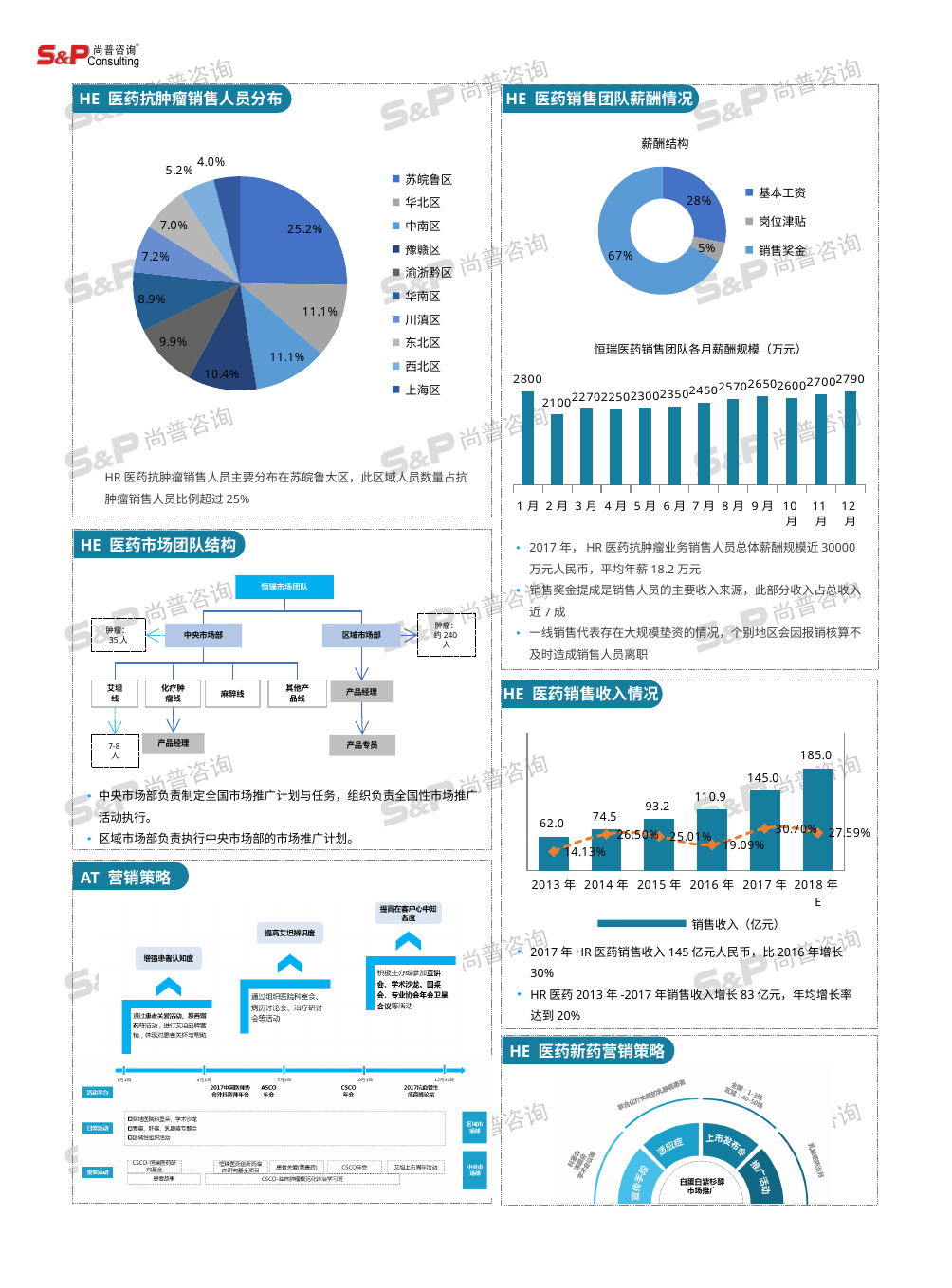
In the bar chart titled '恒瑞医药销售团队各月薪酬规模（万元）', what is the difference between 12月 and 11月? 90 In the chart titled 'HE 医药销售收入情况', what is the growth rate shown for 2014年? 26.50% In the pie chart titled 'HE 医药抗肿瘤销售人员分布', which region has the smallest share? 上海区 In the chart titled 'HE 医药销售收入情况', do the sales revenue bars rise or fall from 2013年 to 2018年E? rise In the bar chart titled '恒瑞医药销售团队各月薪酬规模（万元）', what is the value for 2月? 2100 In the donut chart titled '薪酬结构', what share is 销售奖金? 67% In the bar chart titled '恒瑞医药销售团队各月薪酬规模（万元）', which month has the highest value? 1月 What type of chart is used for '恒瑞医药销售团队各月薪酬规模（万元）'? bar chart In the donut chart titled '薪酬结构', what is the difference between the shares of 基本工资 and 岗位津贴? 23% In the pie chart titled 'HE 医药抗肿瘤销售人员分布', what share does 苏皖鲁区 have? 25.2% In the chart titled 'HE 医药销售收入情况', what is the sales revenue for 2017年? 145.0 How many regions are listed in the legend of the pie chart titled 'HE 医药抗肿瘤销售人员分布'? 10